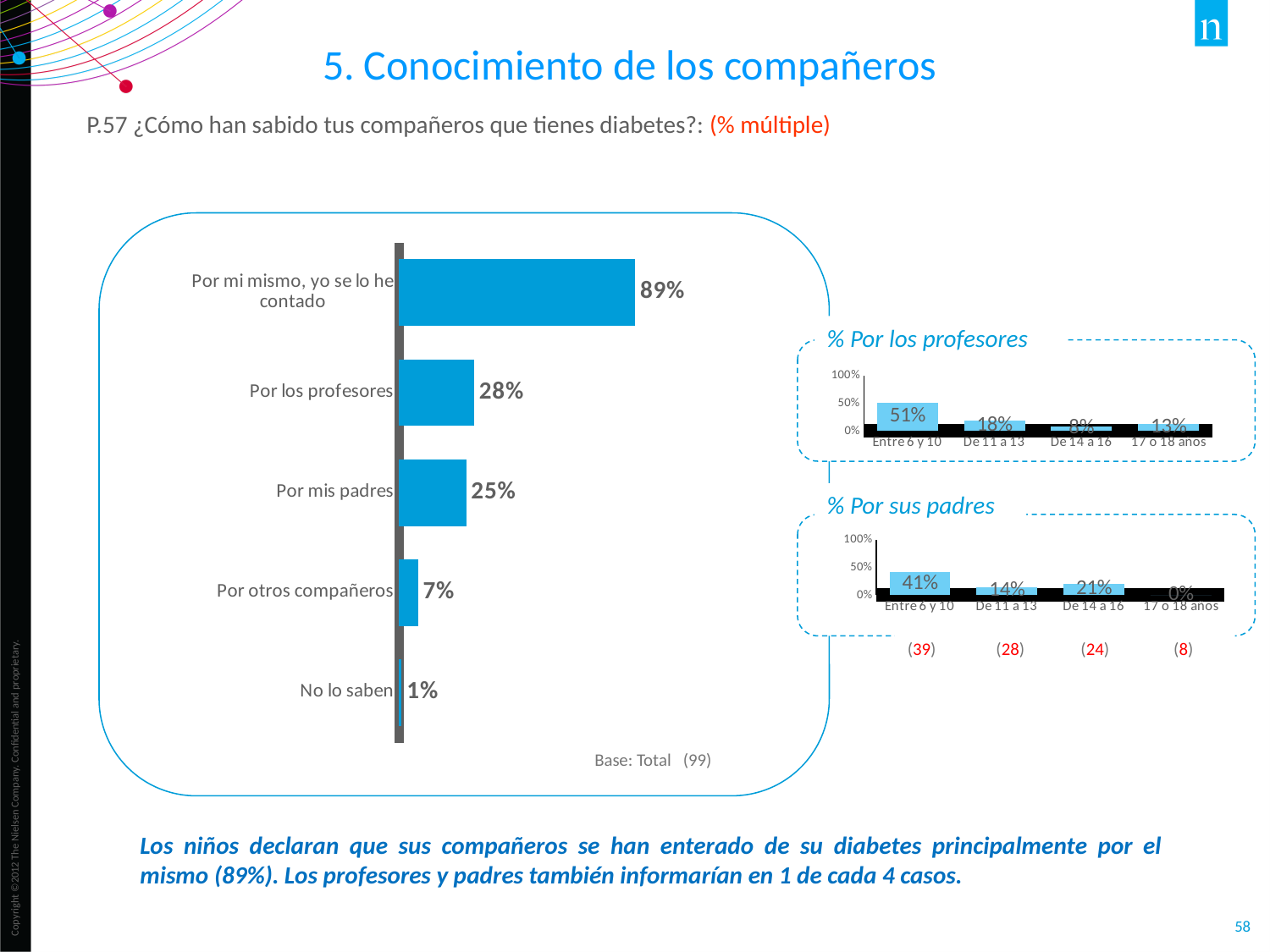
In the '% Por sus padres' chart, which age group has the lowest value? 17 o 18 años What type of chart is the main chart on the left? Bar chart In the '% Por los profesores' chart, what is the value for 'Entre 6 y 10'? 51% In the main bar chart on the left, what percentage is shown for 'Por los profesores'? 28% In the main bar chart on the left, is the value for 'Por otros compañeros' greater or less than 'Por mis padres'? less In the main bar chart on the left, what is the difference between 'Por los profesores' and 'Por mis padres'? 3% In the main bar chart on the left, what percentage is shown for 'Por mi mismo, yo se lo he contado'? 89% In the '% Por sus padres' chart, which is larger: the value for 'De 11 a 13' or 'De 14 a 16'? De 14 a 16 In the main bar chart on the left, which category has the lowest value? No lo saben In the '% Por sus padres' chart, what is the value for 'De 14 a 16'? 21% In the main bar chart on the left, how many categories are shown? 5 In the '% Por los profesores' chart, which age group has the highest value? Entre 6 y 10